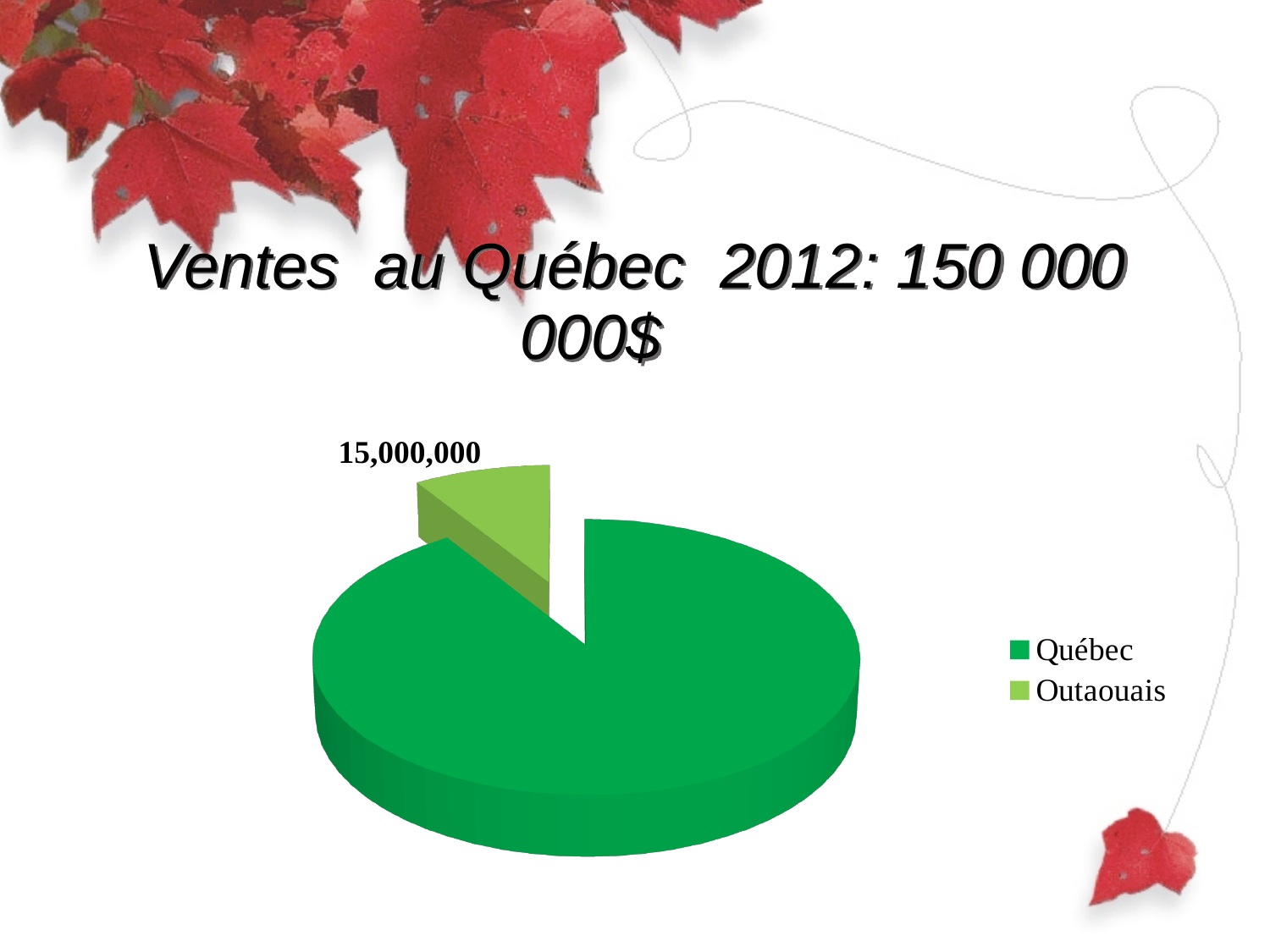
Which category is shown in the lighter green colour in the pie chart? Outaouais How many entries does the legend list? 2 What kind of chart is shown on the slide? Pie chart What is the title of the slide containing the pie chart? Ventes au Québec 2012: 150 000 000$ How many slices does the pie chart have? 2 Which category has the largest slice in the pie chart? Québec Which slice is larger, Québec or Outaouais? Québec What value is shown for the Outaouais slice of the pie chart? 15,000,000 Which category has the smallest slice in the pie chart? Outaouais